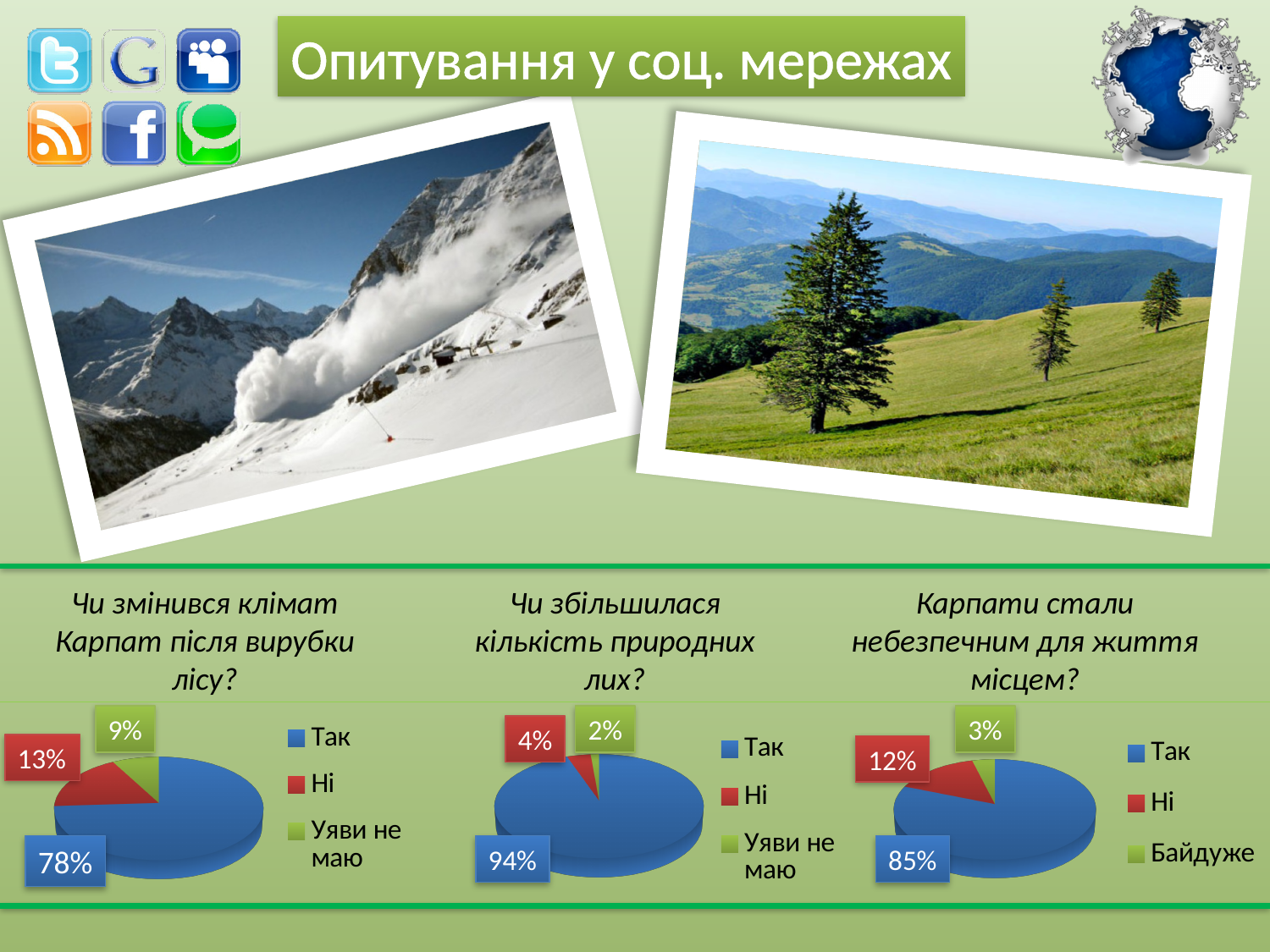
In the middle pie chart ("Чи збільшилася кількість природних лих?"), what share is labelled for "Уяви не маю"? 2% In the middle pie chart ("Чи збільшилася кількість природних лих?"), what share is labelled for "Так"? 94% In the right pie chart ("Карпати стали небезпечним для життя місцем?"), what is the third legend entry after "Так" and "Ні"? Байдуже How many categories does the legend of the left pie chart ("Чи змінився клімат Карпат після вирубки лісу?") list? 3 What type of chart is used for the middle chart ("Чи збільшилася кількість природних лих?")? Pie chart In the left pie chart ("Чи змінився клімат Карпат після вирубки лісу?"), what share is labelled for "Так"? 78% In the right pie chart ("Карпати стали небезпечним для життя місцем?"), what share is labelled for "Ні"? 12% In the left pie chart ("Чи змінився клімат Карпат після вирубки лісу?"), what share is labelled for "Ні"? 13% In the middle pie chart ("Чи збільшилася кількість природних лих?"), what is the difference in percentage points between "Так" and "Ні"? 90 In the right pie chart ("Карпати стали небезпечним для життя місцем?"), which category has the largest slice? Так In the right pie chart ("Карпати стали небезпечним для життя місцем?"), which is larger: the share for "Ні" or the share for "Байдуже"? Ні In the left pie chart ("Чи змінився клімат Карпат після вирубки лісу?"), which category has the smallest slice? Уяви не маю